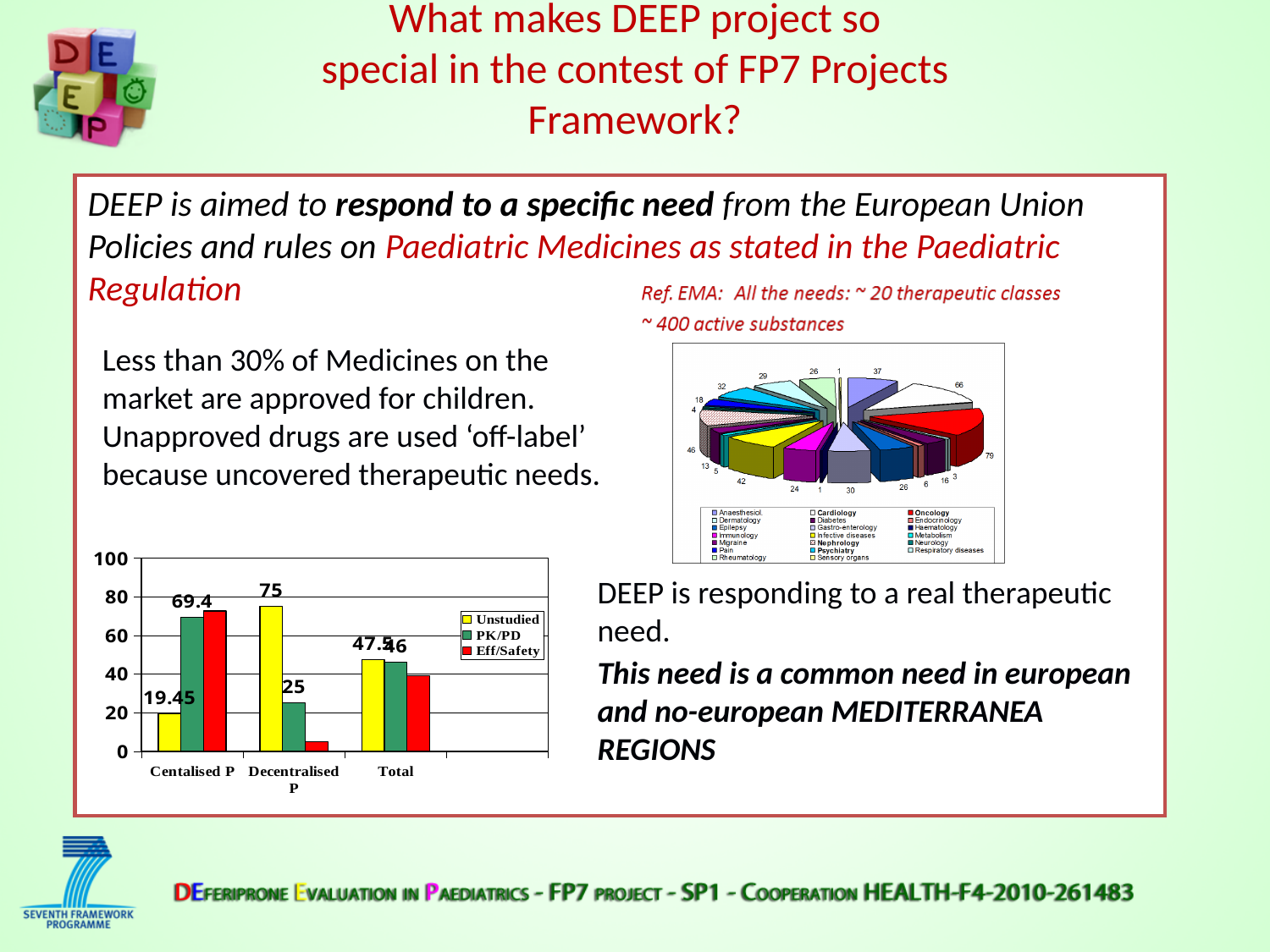
How many therapeutic classes does the legend of the pie chart on the right list? 20 In the bar chart at the bottom left, what is the Unstudied value for Centalised P? 19.45 In the bar chart at the bottom left, what is the difference between the Unstudied values for Decentralised P and Centalised P? 55.55 In the bar chart at the bottom left, which category has the highest Unstudied value? Decentralised P How many series does the legend of the bar chart at the bottom left list? 3 What kind of chart is the chart on the right side of the slide showing therapeutic classes? pie chart In the bar chart at the bottom left, which is larger for Decentralised P: Unstudied or PK/PD? Unstudied In the bar chart at the bottom left, what is the PK/PD value for Total? 46 In the bar chart at the bottom left, is the Eff/Safety value for Decentralised P greater or less than 20? less In the bar chart at the bottom left, what is the PK/PD value for Centalised P? 69.4 In the bar chart at the bottom left, what is the Unstudied value for Decentralised P? 75 In the bar chart at the bottom left, is the Eff/Safety value for Centalised P greater or less than 60? greater